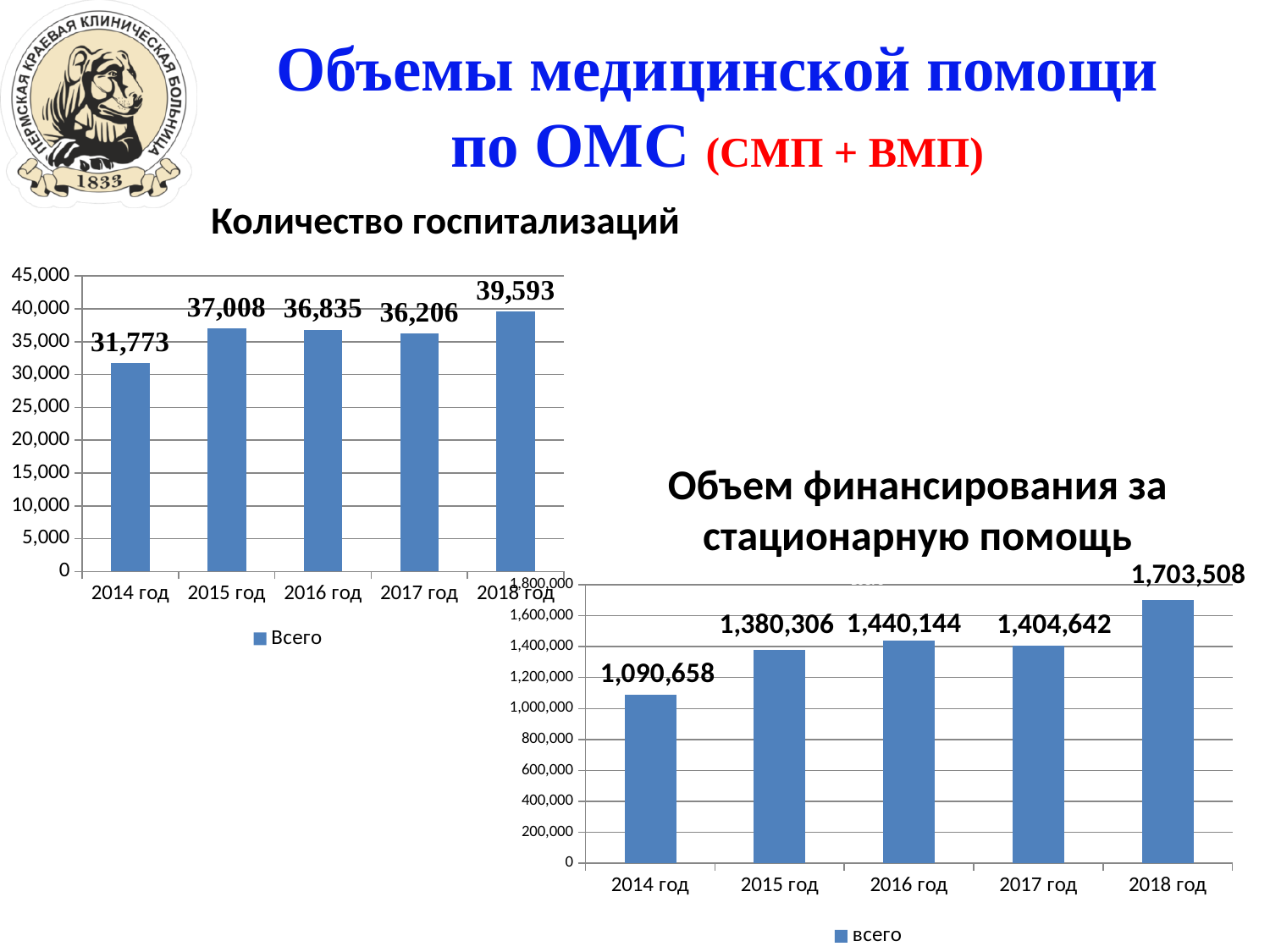
In the 'Объем финансирования за стационарную помощь' chart, which is larger, the value for 2016 год or 2017 год? 2016 год How many years are shown in the 'Количество госпитализаций' chart? 5 In the 'Количество госпитализаций' chart, what is the value for 2014 год? 31,773 In the 'Объем финансирования за стационарную помощь' chart, what is the value for 2015 год? 1,380,306 In the 'Количество госпитализаций' chart, which year has the highest value? 2018 год In the 'Объем финансирования за стационарную помощь' chart, what is the value for 2018 год? 1,703,508 In the 'Количество госпитализаций' chart, what is the value for 2017 год? 36,206 In the 'Объем финансирования за стационарную помощь' chart, which year has the lowest value? 2014 год In the 'Объем финансирования за стационарную помощь' chart, what is the difference between the values for 2018 год and 2014 год? 612,850 What kind of chart is the 'Объем финансирования за стационарную помощь' chart? Bar chart In the 'Количество госпитализаций' chart, which year has the lowest value? 2014 год In the 'Количество госпитализаций' chart, what is the difference between the values for 2018 год and 2014 год? 7,820